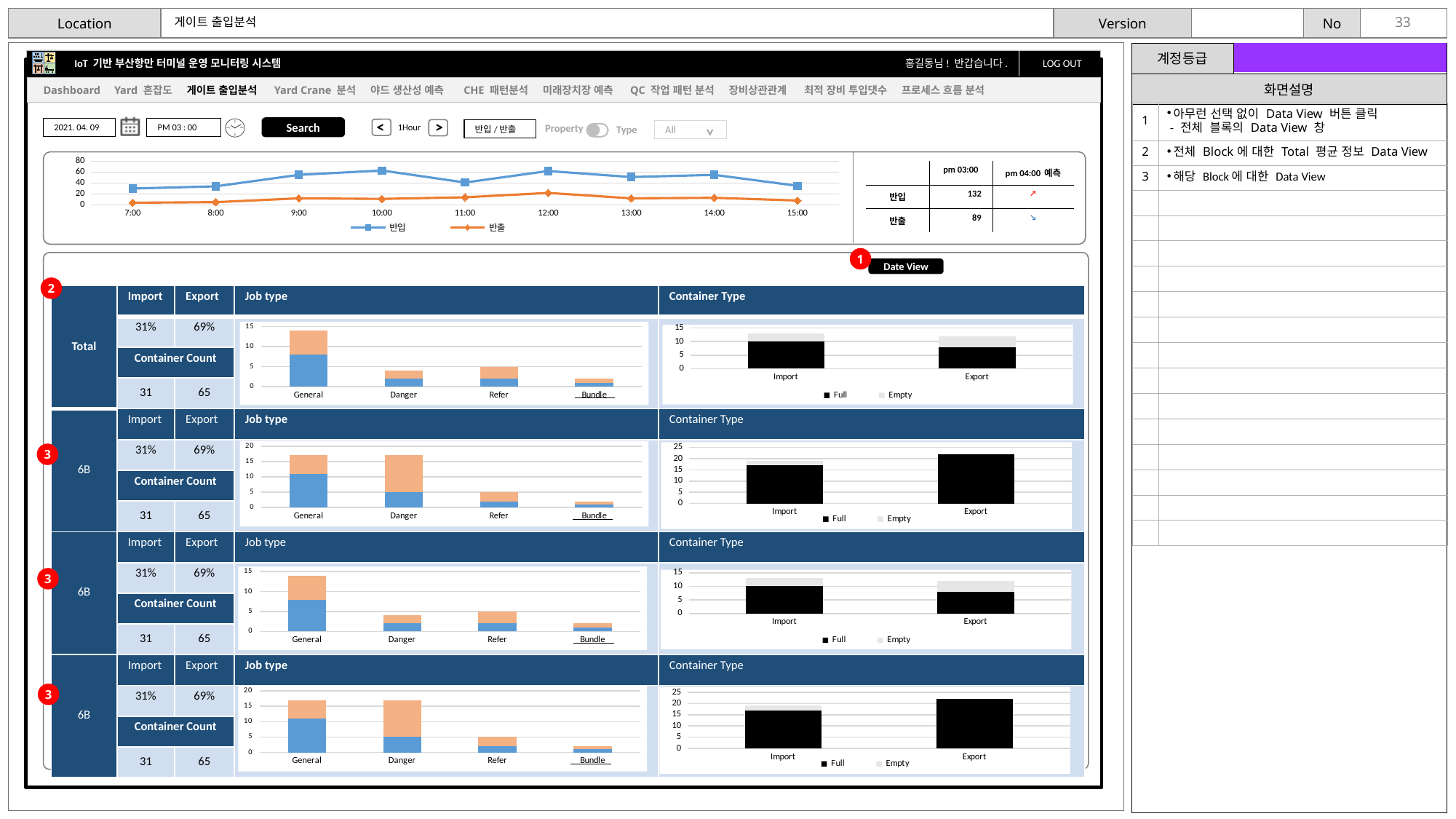
In the Container Type chart of the second row (first 6B block), which bar is taller, Import or Export? Export In the Job type chart of the Total row, how many categories are shown on the x axis? 4 In the top line chart, is the 반입 value at 12:00 greater or less than 40? greater How many series does the legend of the Container Type chart in the Total row list? 2 How many time points are plotted along the x axis of the top line chart? 9 How many series does the legend of the top line chart list? 2 What kind of chart is the chart at the top of the dashboard showing 반입 and 반출 over time? line chart In the top line chart, at which time is the 반출 value highest? 12:00 In the Job type chart of the Total row, which category has the tallest bar? General In the Job type chart of the Total row, which category has the shortest bar? Bundle In the top line chart, which series has the larger value at 10:00, 반입 or 반출? 반입 In the Job type chart of the Total row, is the total bar height for General greater or less than 10? greater